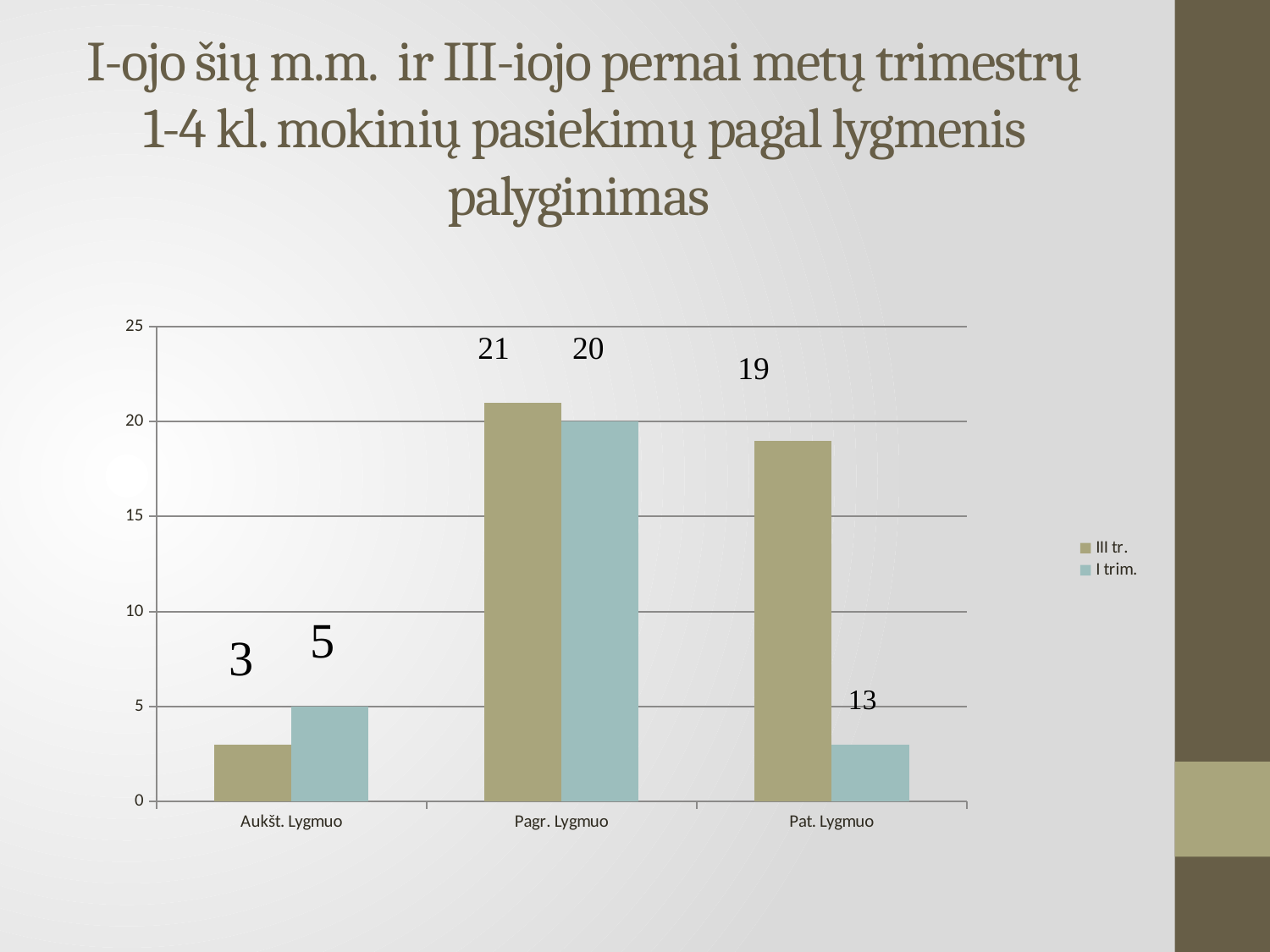
For Aukšt. Lygmuo, which series has the larger value, III tr. or I trim.? I trim. What is the III tr. value for Pagr. Lygmuo? 21 Which category has the lowest III tr. value? Aukšt. Lygmuo What is the I trim. value for Aukšt. Lygmuo? 5 What kind of chart is shown on the slide? bar chart How many series does the legend list? 2 What is the III tr. value for Aukšt. Lygmuo? 3 Which category has the highest III tr. value? Pagr. Lygmuo How many categories are shown on the x axis? 3 What is the III tr. value for Pat. Lygmuo? 19 What is the difference between the III tr. and I trim. values for Pagr. Lygmuo? 1 What is the I trim. value for Pagr. Lygmuo? 20